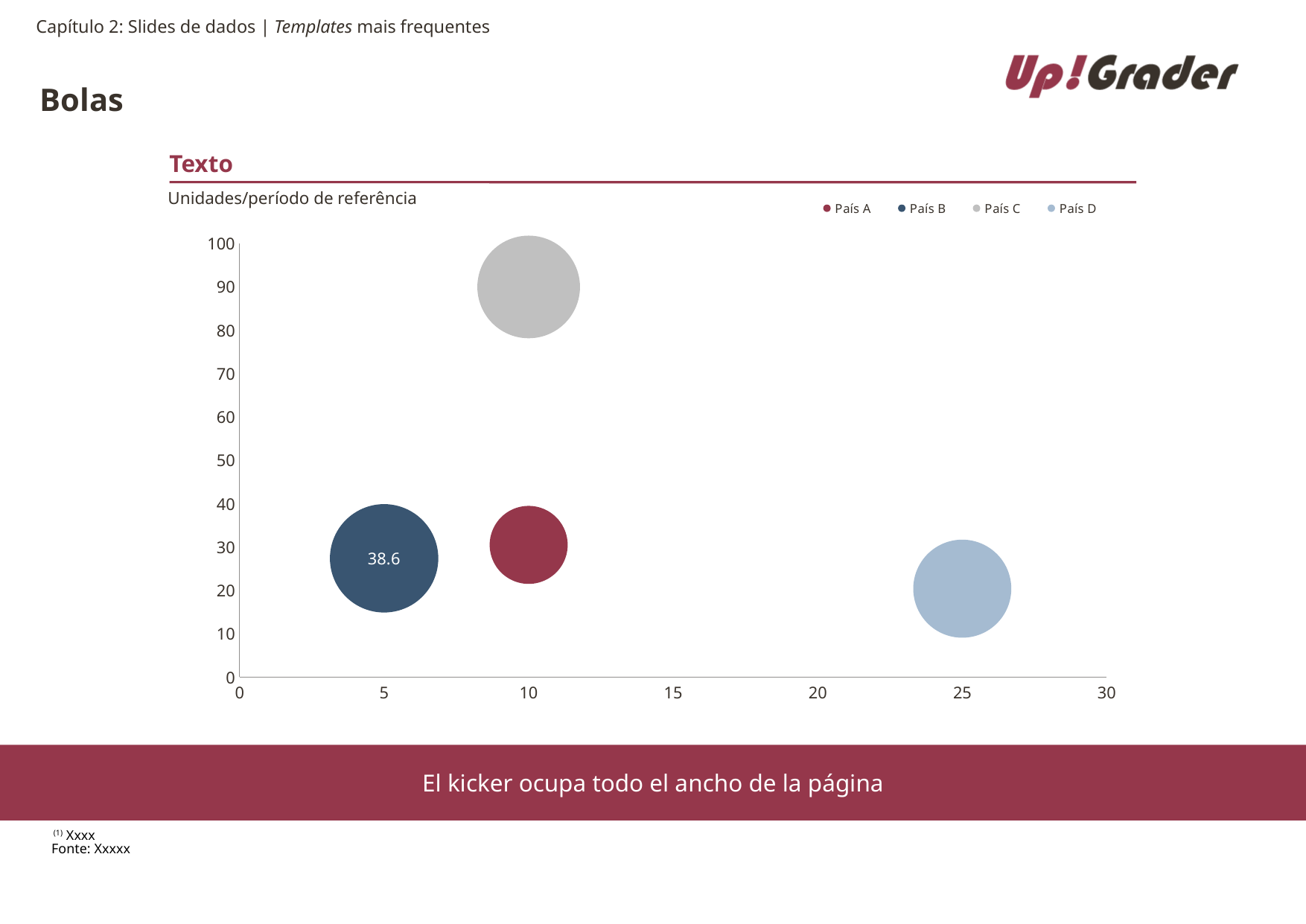
Is the vertical-axis value for País D greater or less than 30? less How many series does the legend list? 4 Which is positioned higher on the vertical axis, País A or País D? País A Which series is plotted furthest to the right on the horizontal axis? País D What kind of chart is shown on the slide? Bubble chart Which series has the highest position on the vertical axis? País C Is the horizontal-axis value for País D greater or less than 20? greater What data label is printed on the País B bubble? 38.6 What colour is the País C bubble? Grey Which series has the lowest position on the vertical axis? País D How many bubbles are plotted on the chart? 4 Is the vertical-axis value for País C greater or less than 80? greater